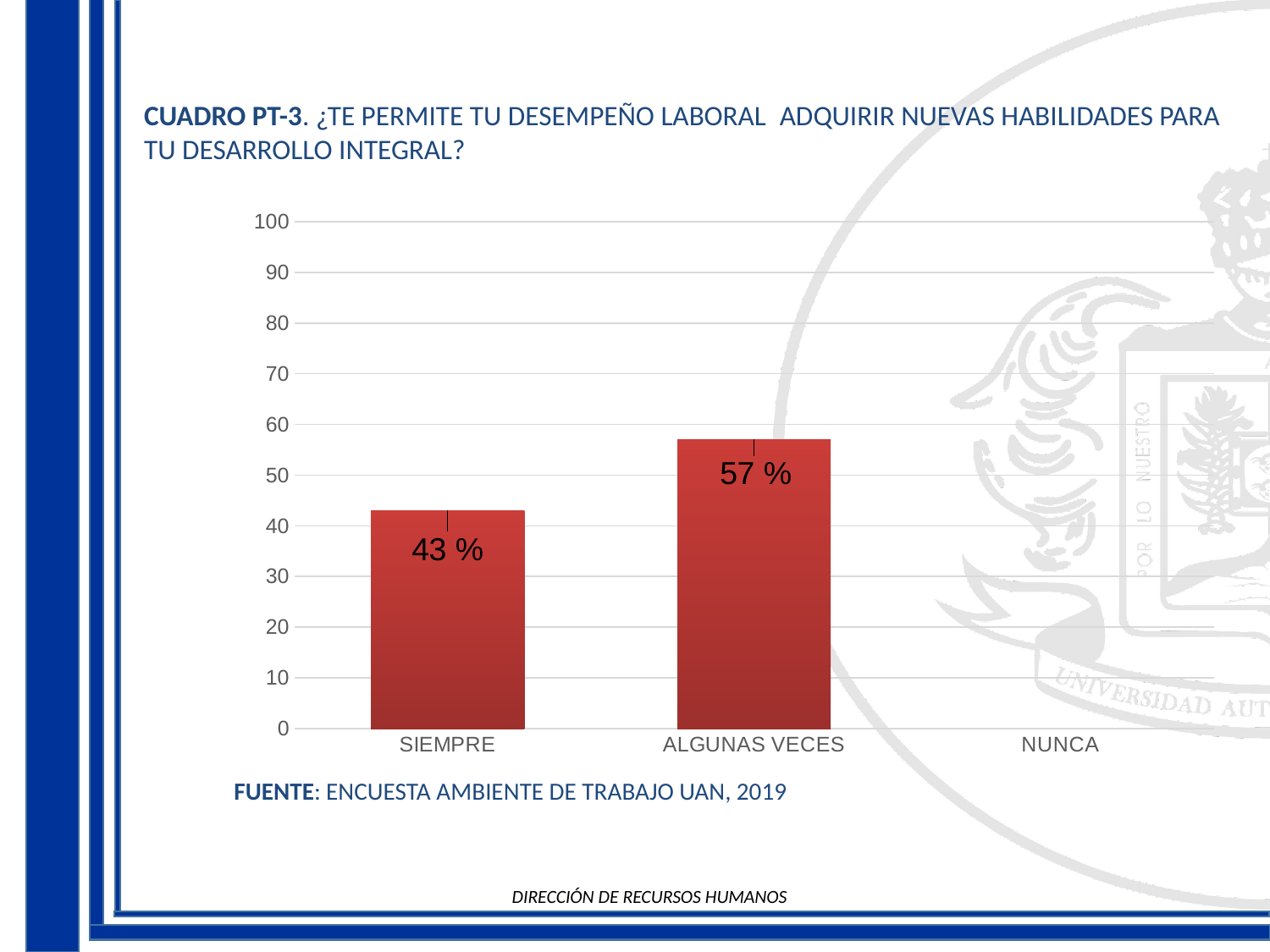
What kind of chart is shown on the slide? bar chart Is the value for SIEMPRE greater or less than 50? less Is the value for ALGUNAS VECES greater or less than 50? greater Which category has the highest value? ALGUNAS VECES Which is larger, the value for SIEMPRE or the value for ALGUNAS VECES? ALGUNAS VECES What is the total of the values for SIEMPRE and ALGUNAS VECES? 100 % What is the source cited below the chart? ENCUESTA AMBIENTE DE TRABAJO UAN, 2019 What is the difference between the values for ALGUNAS VECES and SIEMPRE? 14 % Which category has the lowest value among those with a visible bar? SIEMPRE How many categories are shown on the x axis? 3 What is the value for SIEMPRE? 43 % What is the value for ALGUNAS VECES? 57 %